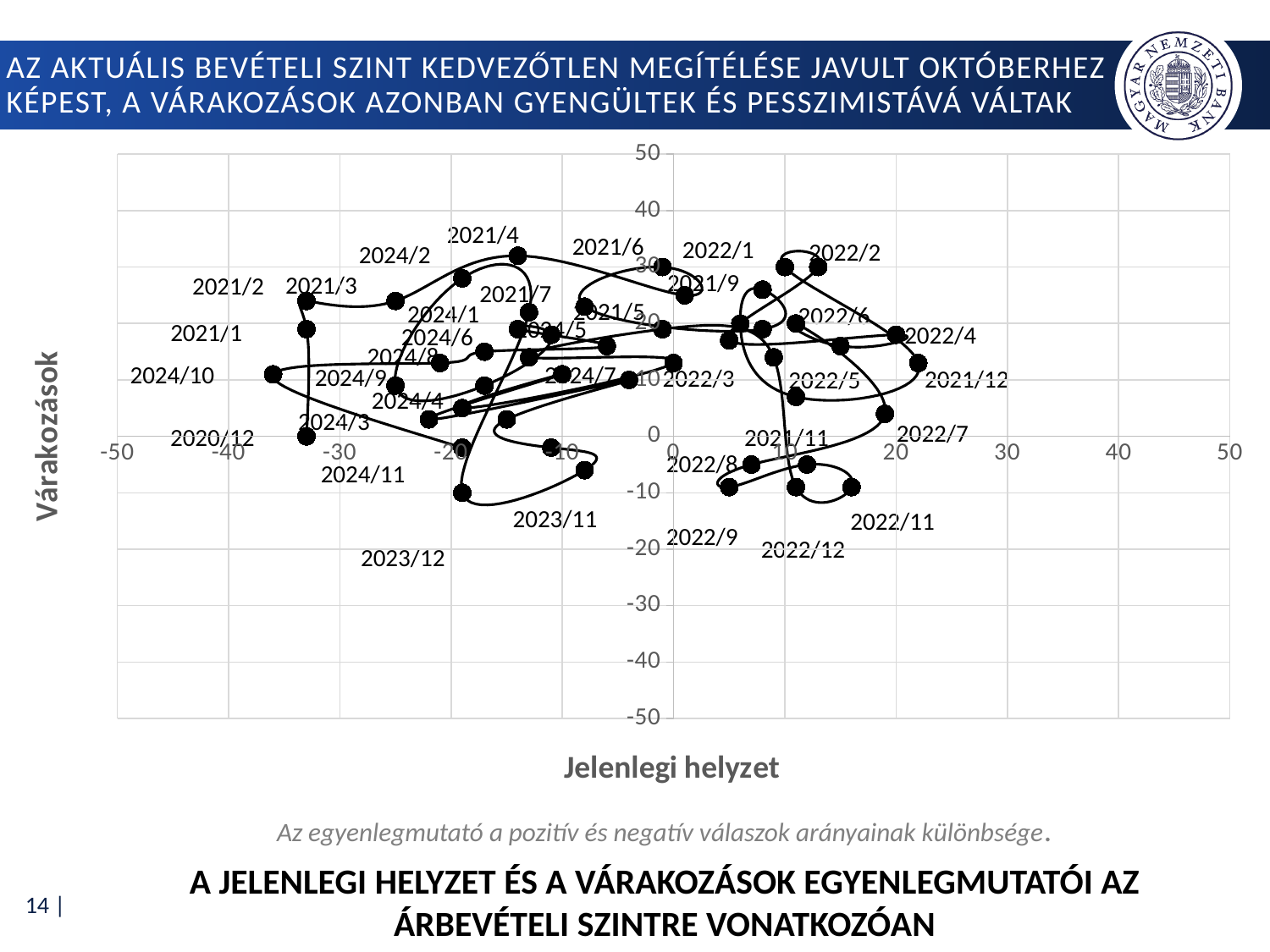
Is the Várakozások value for 2024/10 greater or less than 0? greater What kind of chart is shown on the slide? scatter chart Is the Jelenlegi helyzet value for 2022/11 greater or less than 0? greater What is the title of the horizontal axis of the chart? Jelenlegi helyzet Is the Jelenlegi helyzet value for 2024/10 greater or less than -30? less What is the title of the vertical axis of the chart? Várakozások Which point has the higher Várakozások value, 2021/4 or 2023/11? 2021/4 Which point has the higher Jelenlegi helyzet value, 2024/10 or 2021/12? 2021/12